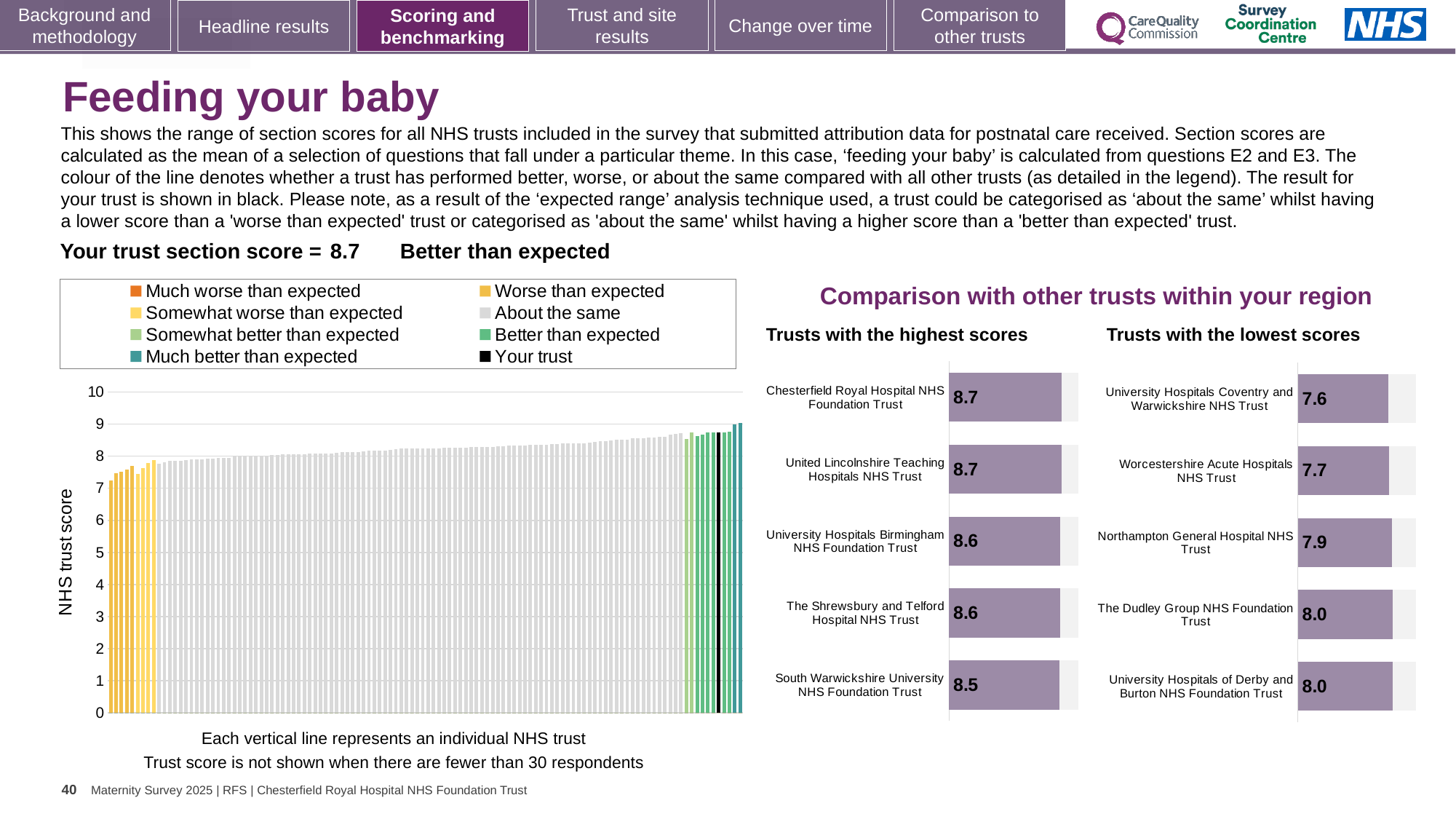
What kind of chart is the large chart on the left showing all NHS trusts? bar chart In the 'Trusts with the highest scores' chart, which has the higher score: University Hospitals Birmingham NHS Foundation Trust or South Warwickshire University NHS Foundation Trust? University Hospitals Birmingham NHS Foundation Trust How many trusts are listed in the 'Trusts with the lowest scores' chart? 5 What is the difference between the score for Chesterfield Royal Hospital NHS Foundation Trust in the highest scores chart and the score for University Hospitals Coventry and Warwickshire NHS Trust in the lowest scores chart? 1.1 In the 'Trusts with the lowest scores' chart, which trust has the lowest score? University Hospitals Coventry and Warwickshire NHS Trust In the 'Trusts with the highest scores' chart, which trust has the lowest score shown? South Warwickshire University NHS Foundation Trust In the 'Trusts with the lowest scores' chart, what is the difference between the scores for Northampton General Hospital NHS Trust and Worcestershire Acute Hospitals NHS Trust? 0.2 In the large chart on the left showing all NHS trusts, do the bar values rise or fall from left to right? rise In the 'Trusts with the lowest scores' chart, what is the score for University Hospitals Coventry and Warwickshire NHS Trust? 7.6 In the 'Trusts with the highest scores' chart, what is the score for Chesterfield Royal Hospital NHS Foundation Trust? 8.7 In the 'Trusts with the highest scores' chart, what is the score for South Warwickshire University NHS Foundation Trust? 8.5 In the 'Trusts with the lowest scores' chart, what is the score for Northampton General Hospital NHS Trust? 7.9